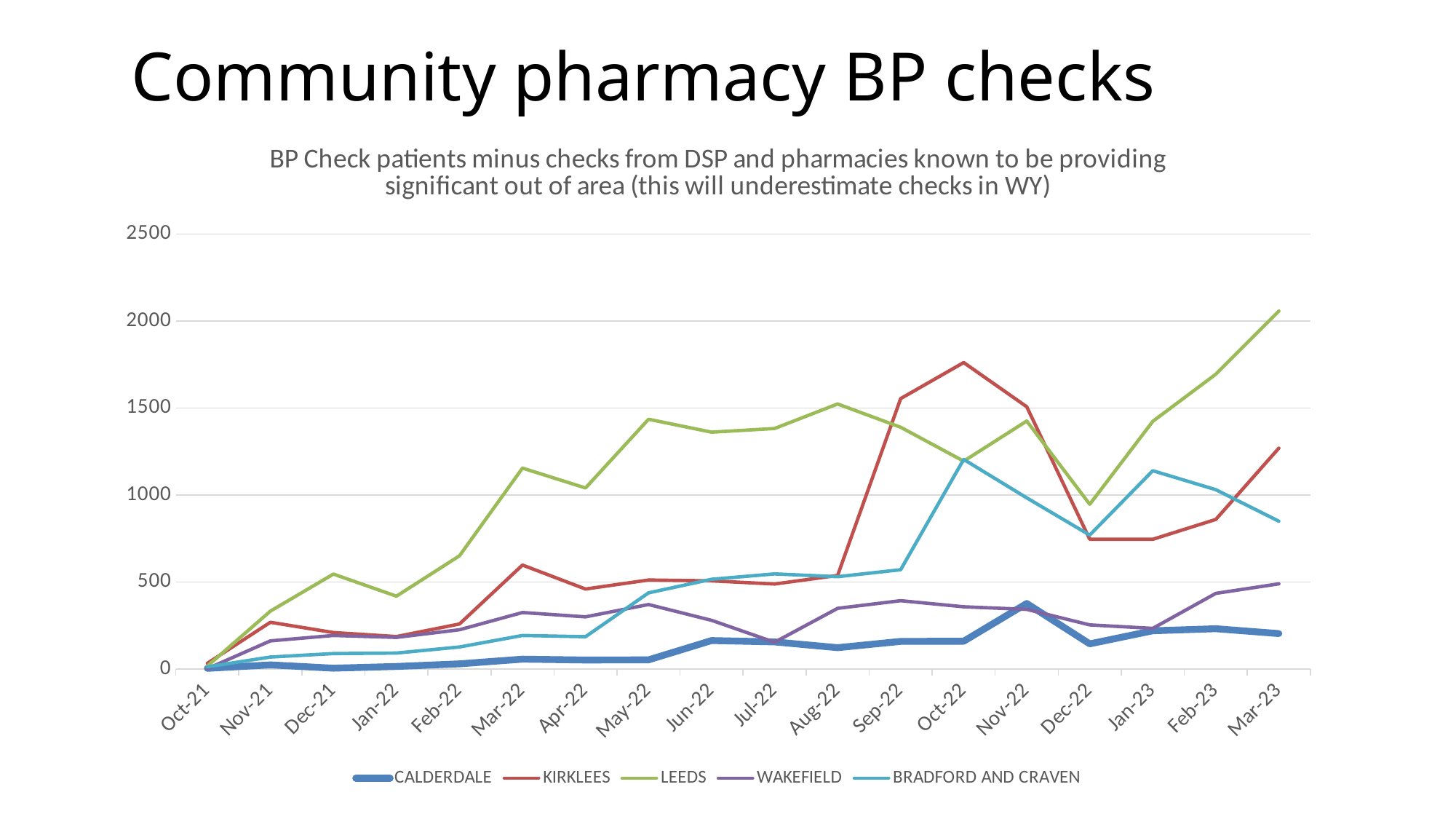
At Oct-22, which series is higher, KIRKLEES or LEEDS? KIRKLEES Which series has the highest value at Mar-23? LEEDS Is the value for LEEDS at Mar-23 greater or less than 2000? greater Is the value for BRADFORD AND CRAVEN at Oct-22 greater or less than 1000? greater Which series has the lowest value at Mar-23? CALDERDALE Is the value for CALDERDALE at Mar-23 greater or less than 500? less What kind of chart is shown on the slide? line chart How many series does the legend list? 5 How many months are shown along the x axis? 18 In which month does KIRKLEES reach its highest value? Oct-22 Does the LEEDS line rise or fall from Dec-22 to Mar-23? rise